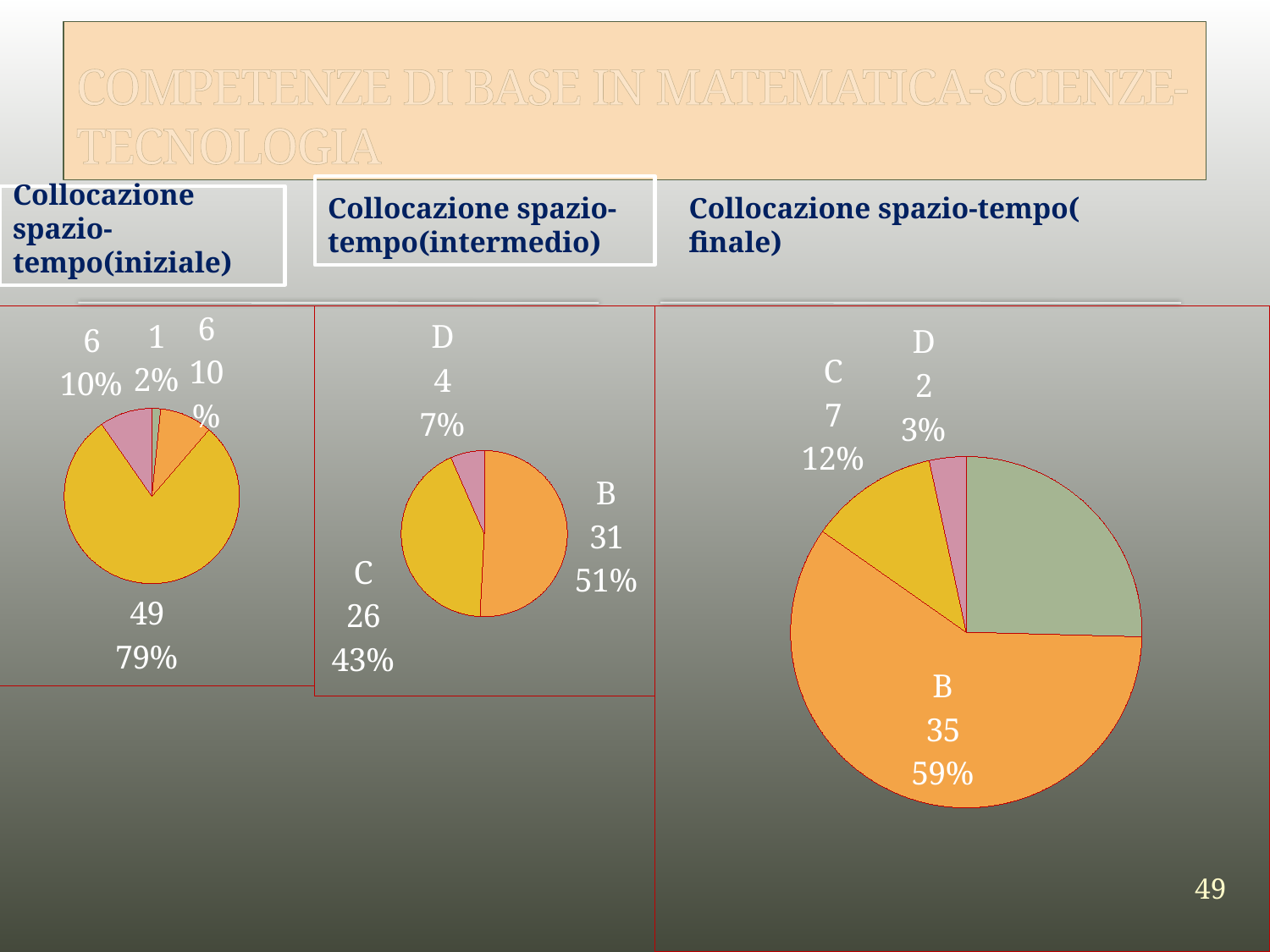
In the 'Collocazione spazio-tempo(iniziale)' chart, what percentage is shown for the largest slice? 79% In the 'Collocazione spazio-tempo(intermedio)' chart, what percentage is shown for category D? 7% In the 'Collocazione spazio-tempo(intermedio)' chart, what percentage is shown for category C? 43% What kind of chart is used for 'Collocazione spazio-tempo(iniziale)'? Pie chart In the 'Collocazione spazio-tempo(intermedio)' chart, which category has the largest slice? B In the 'Collocazione spazio-tempo(finale)' chart, what value is shown for category B? 35 In the 'Collocazione spazio-tempo(finale)' chart, which is larger, the value for C or the value for D? C In the 'Collocazione spazio-tempo(finale)' chart, which labelled category has the smallest slice? D In the 'Collocazione spazio-tempo(finale)' chart, what percentage is shown for category C? 12% In the 'Collocazione spazio-tempo(intermedio)' chart, what value is shown for category B? 31 In the 'Collocazione spazio-tempo(finale)' chart, what value is shown for category D? 2 In the 'Collocazione spazio-tempo(intermedio)' chart, what is the difference between the values for B and C? 5